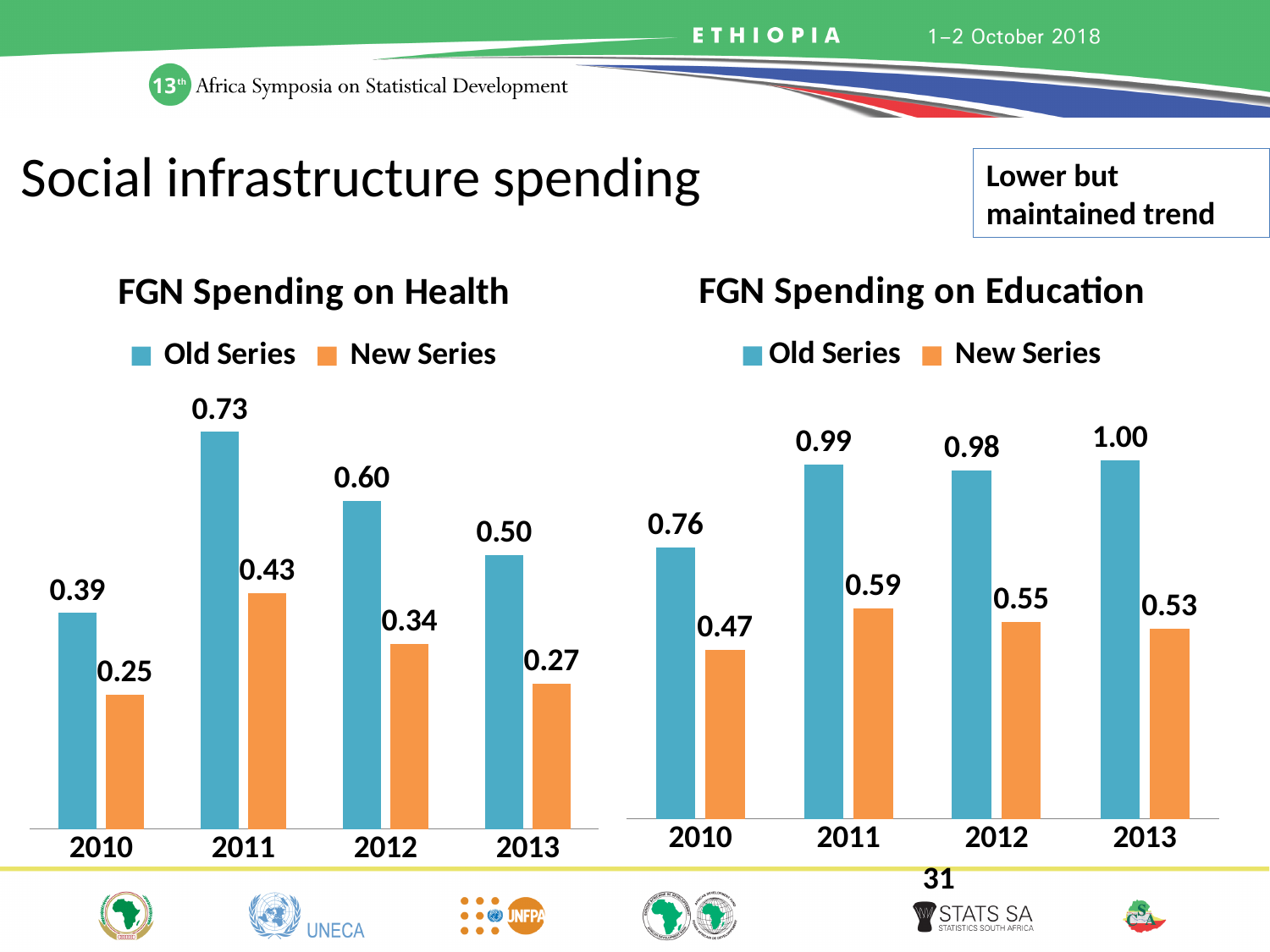
In the 'FGN Spending on Education' chart, what is the difference between the Old Series and New Series values for 2012? 0.43 In the 'FGN Spending on Health' chart, which year has the lowest New Series value? 2010 In the 'FGN Spending on Health' chart, does the Old Series value rise or fall from 2011 to 2013? Fall In the 'FGN Spending on Education' chart, which year has the highest Old Series value? 2013 In the 'FGN Spending on Health' chart, what is the Old Series value for 2011? 0.73 In the 'FGN Spending on Health' chart, what is the New Series value for 2013? 0.27 In the 'FGN Spending on Education' chart, what is the New Series value for 2010? 0.47 In the 'FGN Spending on Education' chart, which is larger: the New Series value for 2011 or the New Series value for 2013? 2011 In the 'FGN Spending on Health' chart, what is the difference between the Old Series and New Series values for 2011? 0.30 How many years are shown on the x axis of the 'FGN Spending on Health' chart? 4 How many series does the legend of the 'FGN Spending on Education' chart list? 2 What kind of chart is 'FGN Spending on Health'? Bar chart